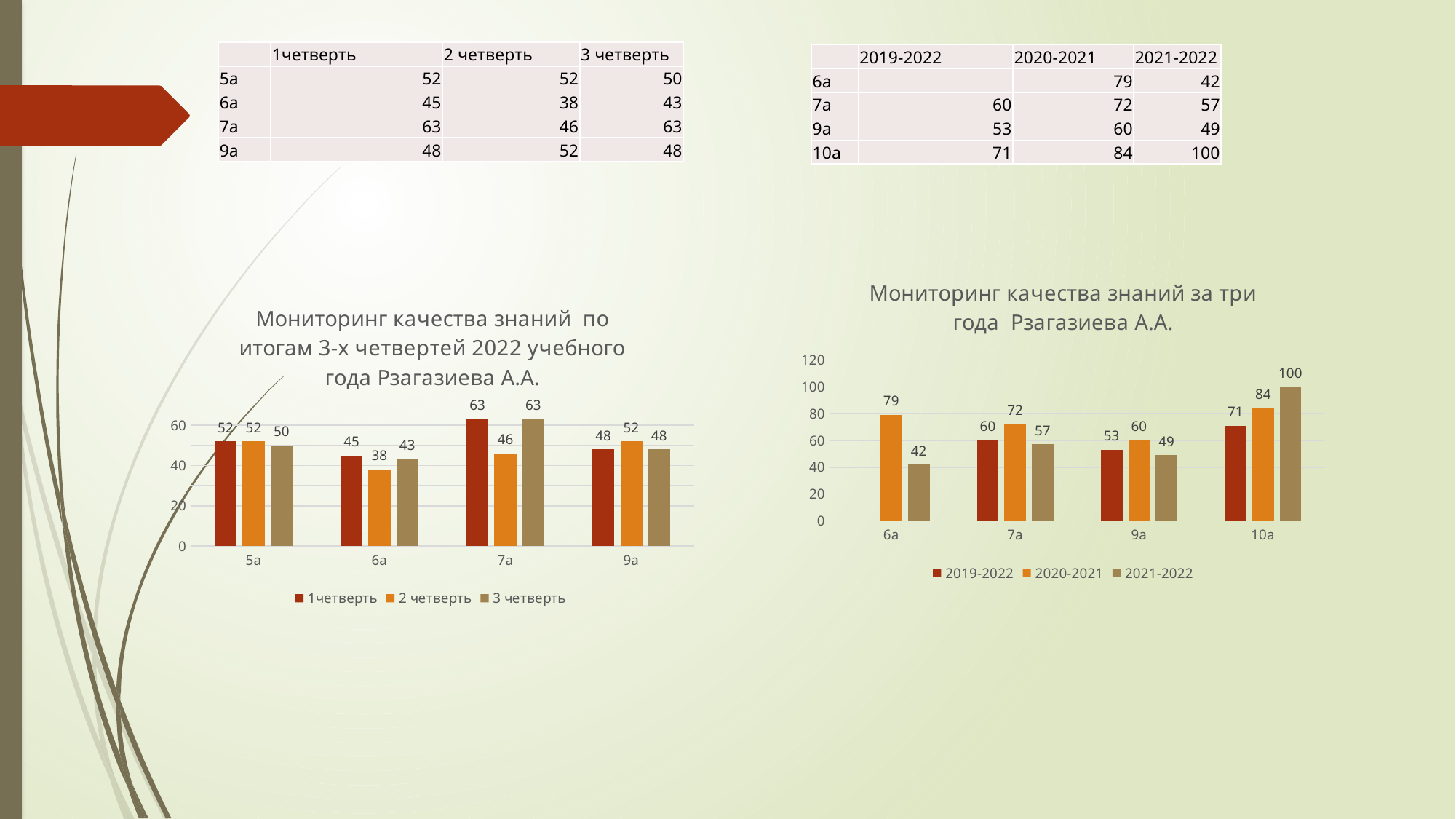
In the right chart (Мониторинг качества знаний за три года), what is the difference between the 2020-2021 and 2021-2022 values for 6а? 37 In the right chart (Мониторинг качества знаний за три года), what kind of chart is it? bar chart In the right chart (Мониторинг качества знаний за три года), which series is shown in orange according to the legend? 2020-2021 In the left chart (Мониторинг качества знаний по итогам 3-х четвертей), which is larger for 9а: 1четверть or 2 четверть? 2 четверть In the right chart (Мониторинг качества знаний за три года), what is the value for 10а in 2021-2022? 100 In the left chart (Мониторинг качества знаний по итогам 3-х четвертей), how many classes are shown on the x axis? 4 In the left chart (Мониторинг качества знаний по итогам 3-х четвертей), what is the difference between the 1четверть and 2 четверть values for 7а? 17 In the right chart (Мониторинг качества знаний за три года), do the 2019-2022 values rise or fall from 7а to 9а? fall In the left chart (Мониторинг качества знаний по итогам 3-х четвертей), which class has the highest value in 1четверть? 7а In the left chart (Мониторинг качества знаний по итогам 3-х четвертей), how many series does the legend list? 3 In the left chart (Мониторинг качества знаний по итогам 3-х четвертей), what is the value for 6а in 2 четверть? 38 In the right chart (Мониторинг качества знаний за три года), which class has the lowest value in 2021-2022? 6а